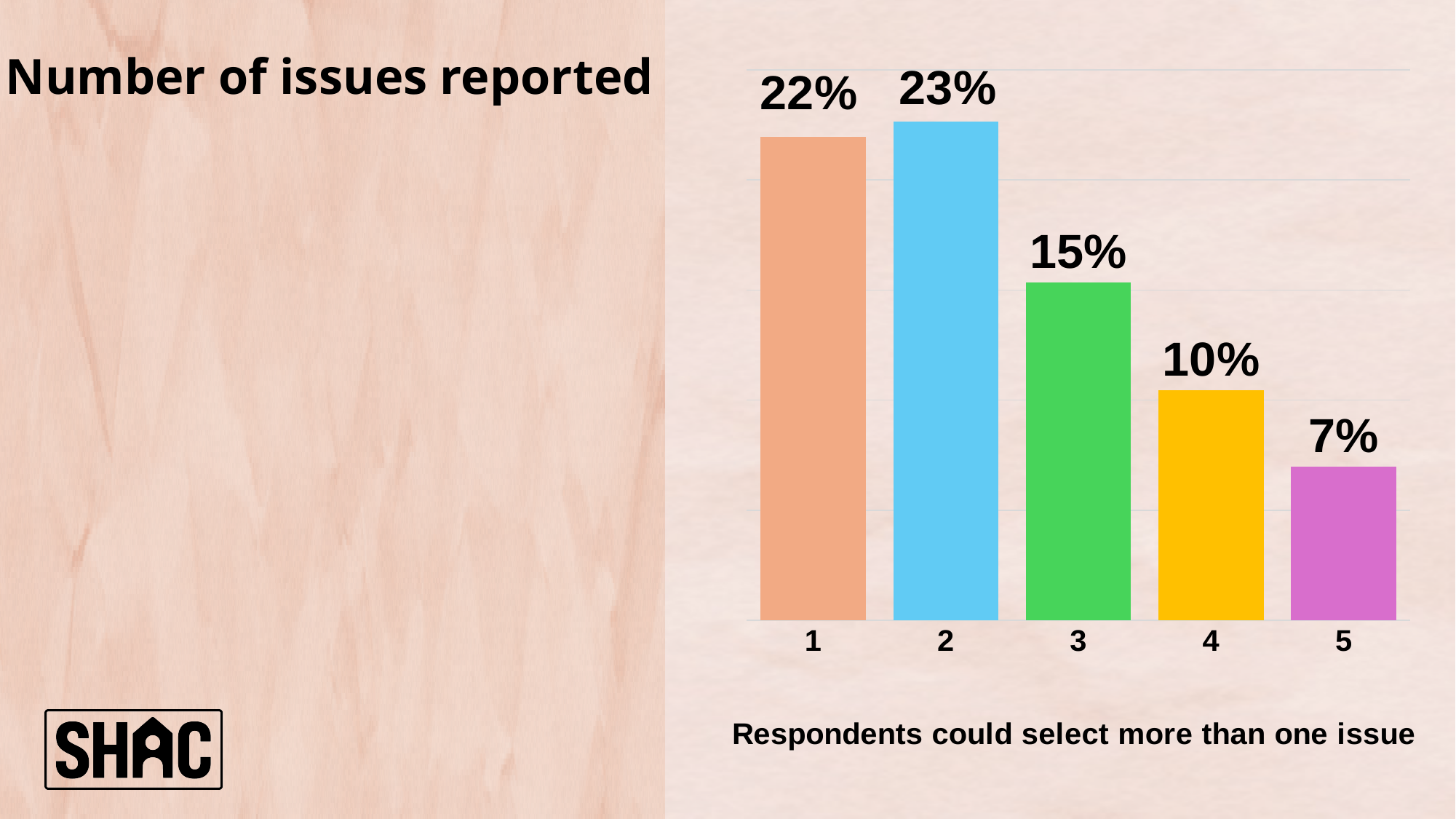
What percentage is shown for category 1? 22% What kind of chart is shown on the slide? bar chart Which category has the lowest value? 5 What percentage is shown for category 2? 23% What is the difference between the values for category 3 and category 4? 5% Which is larger, the value for category 1 or the value for category 3? 1 What percentage is shown for category 3? 15% What is the difference between the values for category 2 and category 5? 16% Which category has the highest value? 2 How many categories are shown on the x axis? 5 What is the title of the slide? Number of issues reported What percentage is shown for category 5? 7%